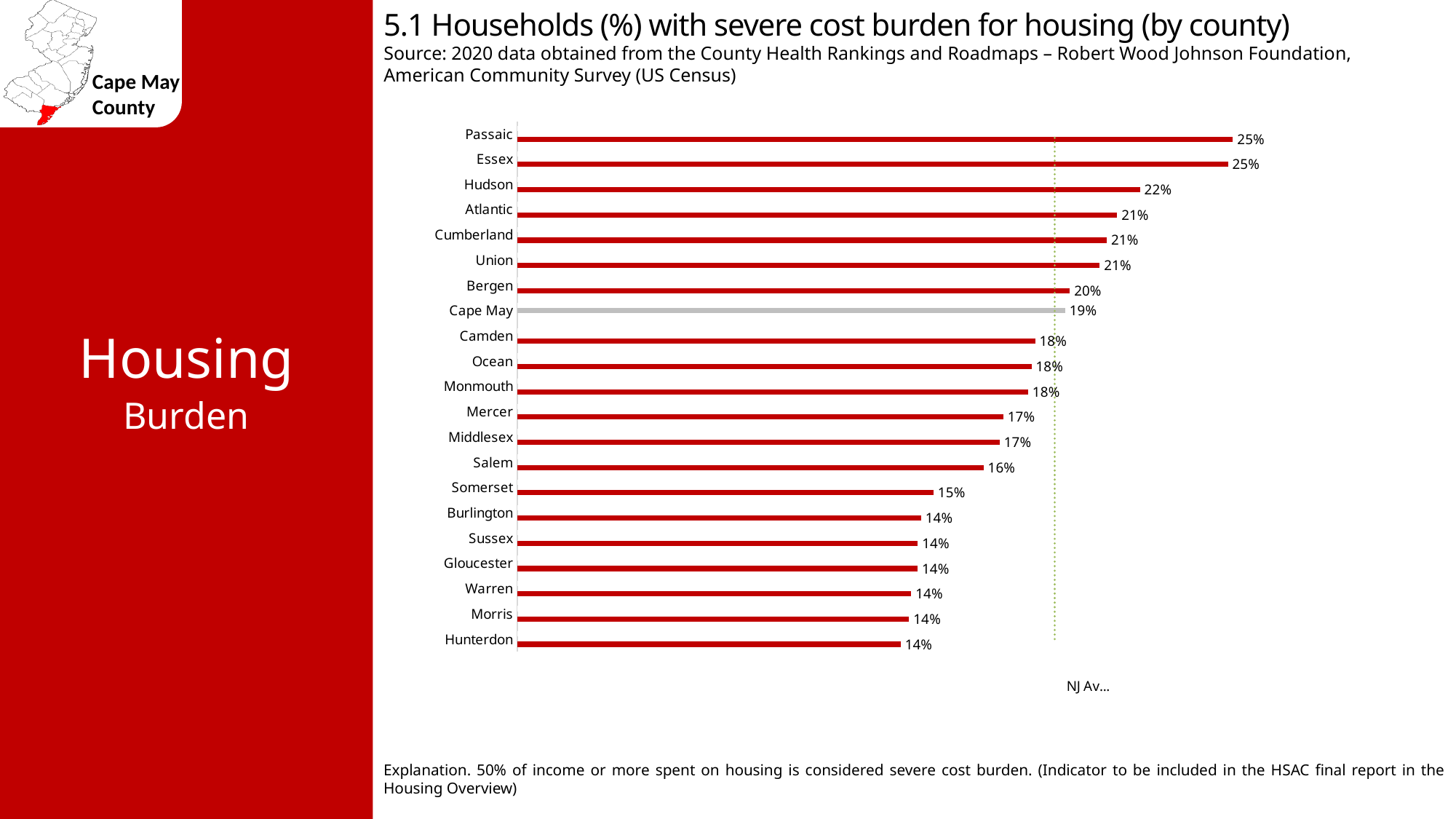
What is the value shown for Somerset County? 15% How many counties are shown on the chart? 21 What type of chart is used on this slide? Bar chart What is the difference between the values for Passaic and Cape May? 6% What is the highest value shown on the chart? 25% What is the value shown for Hudson County? 22% Which has a higher value, Mercer or Hudson? Hudson What is the lowest value shown on the chart? 14% What is the value shown for Salem County? 16% Which has a higher value, Atlantic or Camden? Atlantic What percentage of households in Cape May County have a severe housing cost burden? 19% What is the difference between the values for Bergen and Hunterdon? 6%